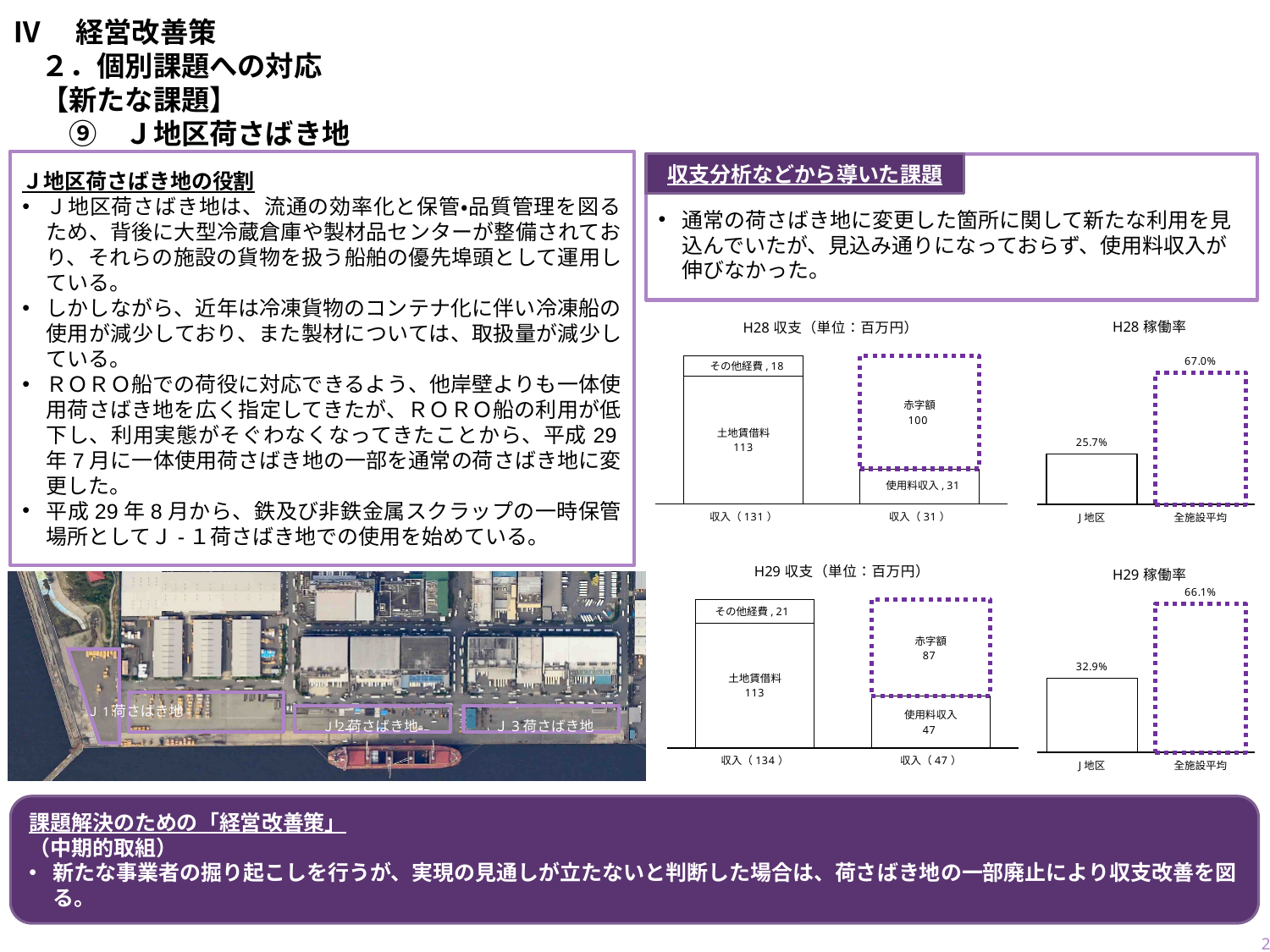
In the H29 稼働率 chart, what is the value for J地区? 32.9% In the H29 収支 chart, what is the value of その他経費? 21 In the H28 収支 chart, what is the value of 土地賃借料? 113 In the H29 収支 chart, what is the total of the left stacked bar (その他経費 plus 土地賃借料)? 134 What kind of chart is the H28 稼働率 chart? bar chart In the H29 稼働率 chart, what is the difference between 全施設平均 and J地区? 33.2% In the H28 収支 chart, which is larger, 土地賃借料 or 使用料収入? 土地賃借料 In the H28 稼働率 chart, what is the value for 全施設平均? 67.0% In the H28 収支 chart, what is the value of 赤字額? 100 In the H28 稼働率 chart, what is the value for J地区? 25.7% In the H29 稼働率 chart, which category has the higher value? 全施設平均 In the H29 収支 chart, what is the value of 使用料収入? 47